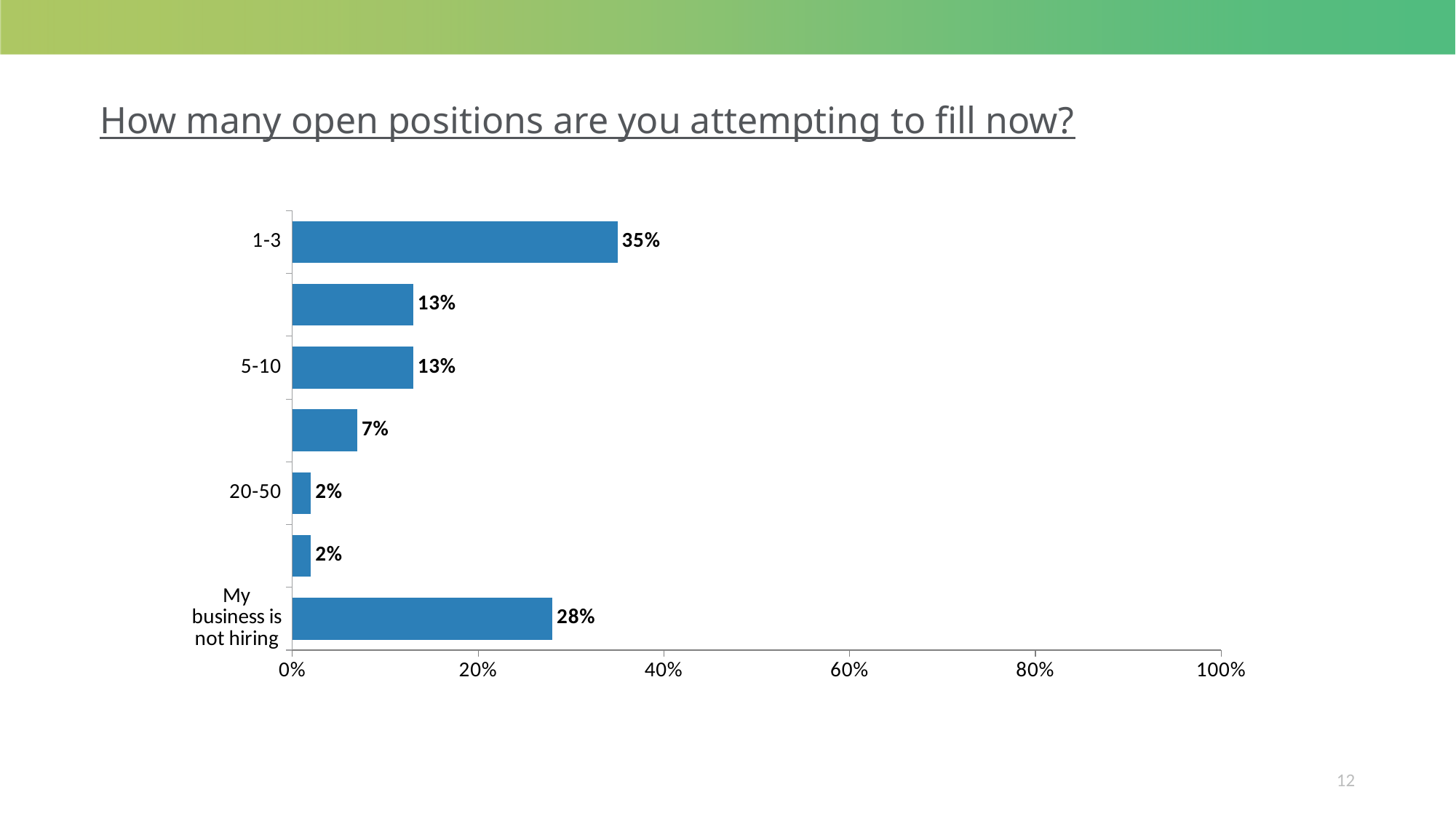
What is the difference between the value for 1-3 and the value for 'My business is not hiring'? 7% Which category has the highest value? 1-3 Is the value for 1-3 greater or less than 20%? greater What is the value for the 20-50 category? 2% Which is larger, the value for 5-10 or the value for 'My business is not hiring'? My business is not hiring What is the value for the 5-10 category? 13% What kind of chart is shown on the slide? bar chart What percentage of respondents are attempting to fill 1-3 open positions? 35% What percentage of respondents said 'My business is not hiring'? 28% What is the title of the slide? How many open positions are you attempting to fill now? How many bars are plotted in the chart? 7 What is the difference between the value for 1-3 and the value for 5-10? 22%